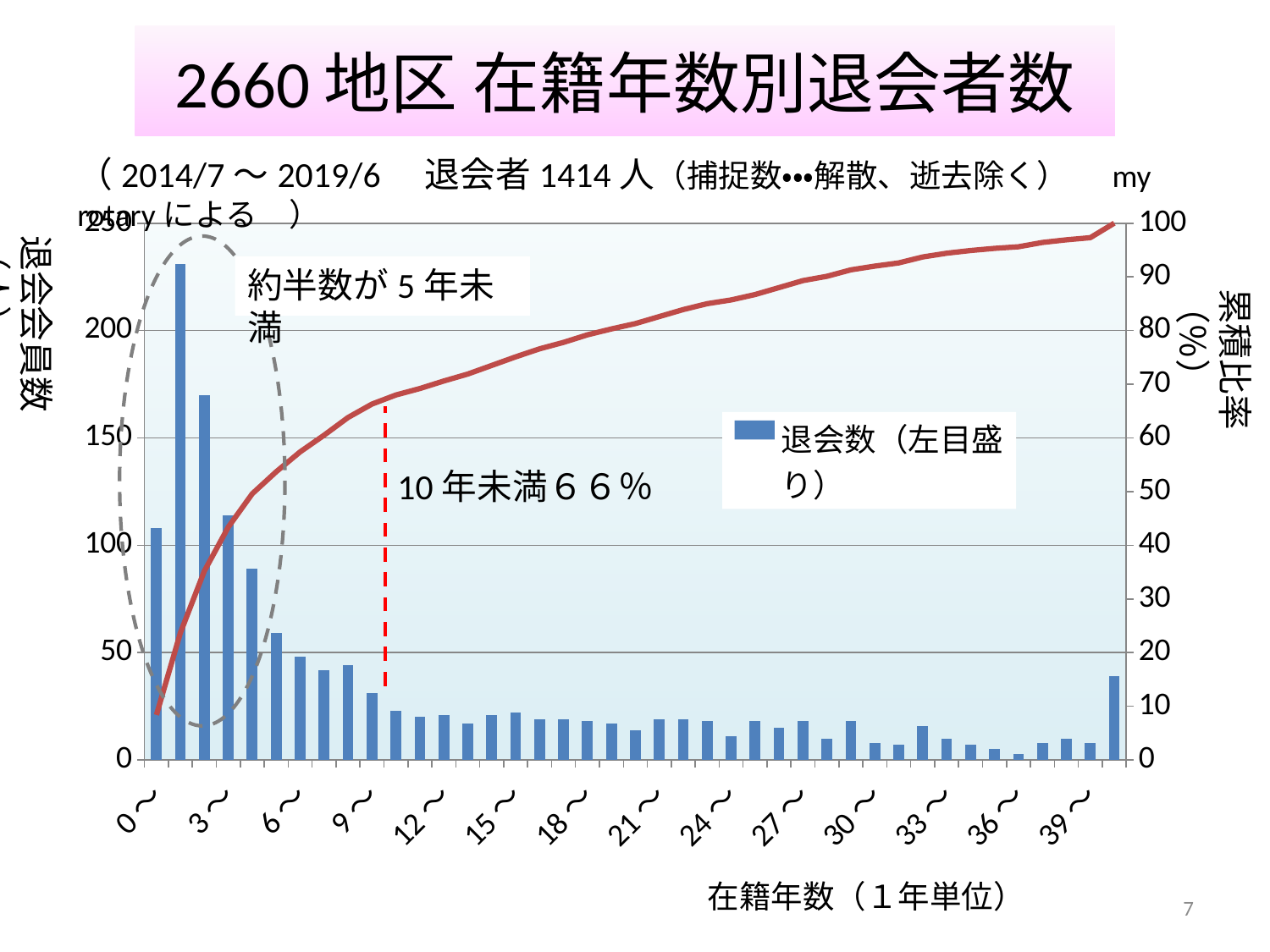
Does the red cumulative line rise or fall as the years of membership increase along the x axis? rise Is the bar value for 9~ greater or less than 50? less What is the title of the chart on the slide? 2660地区 在籍年数別退会者数 What entry does the chart's legend list? 退会数（左目盛り） Is the bar value for 3~ greater or less than 150? less Is the bar value for 0~ greater or less than 50? greater What kind of chart is shown on the slide? A bar chart combined with a line chart Which is larger, the bar value for 0~ or the bar value for 9~? 0~ Which is larger, the bar value for 3~ or the bar value for 6~? 3~ According to the annotation on the chart, what cumulative percentage of leavers had less than 10 years of membership? 66% According to the subtitle, how many leavers (退会者) are covered by the chart? 1414人